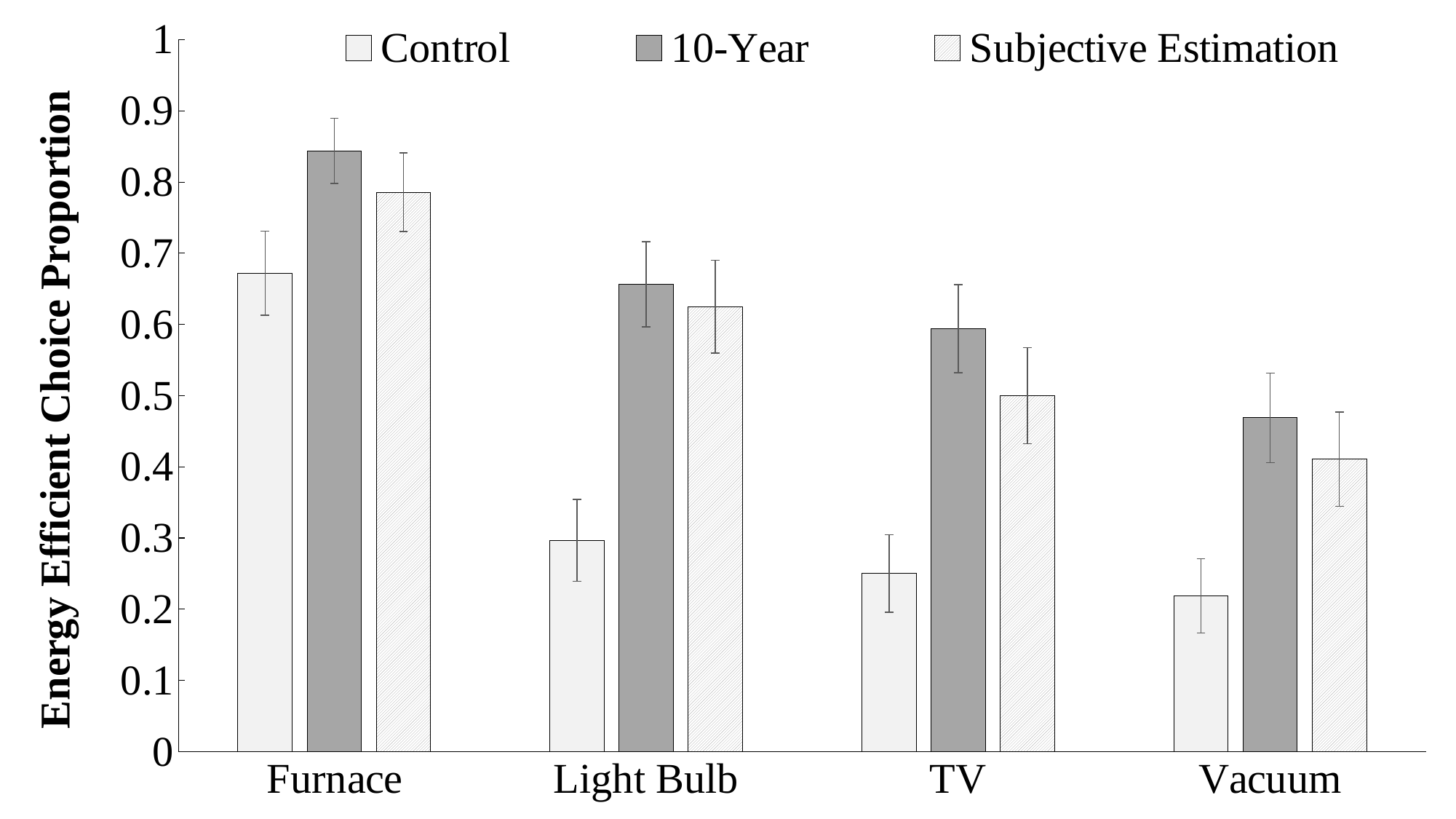
For TV, which is larger: the 10-Year value or the Subjective Estimation value? 10-Year What is the label of the y axis? Energy Efficient Choice Proportion For which category is the 10-Year bar highest? Furnace What kind of chart is shown on the slide? bar chart How many product categories are shown on the x axis? 4 Is the Control value for TV greater or less than 0.3? less Is the Control value for Furnace greater or less than 0.6? greater Which series is shown with the hatched (diagonal-striped) bars? Subjective Estimation Is the 10-Year value for Furnace greater or less than 0.8? greater For which category is the 10-Year bar lowest? Vacuum How many series does the legend list? 3